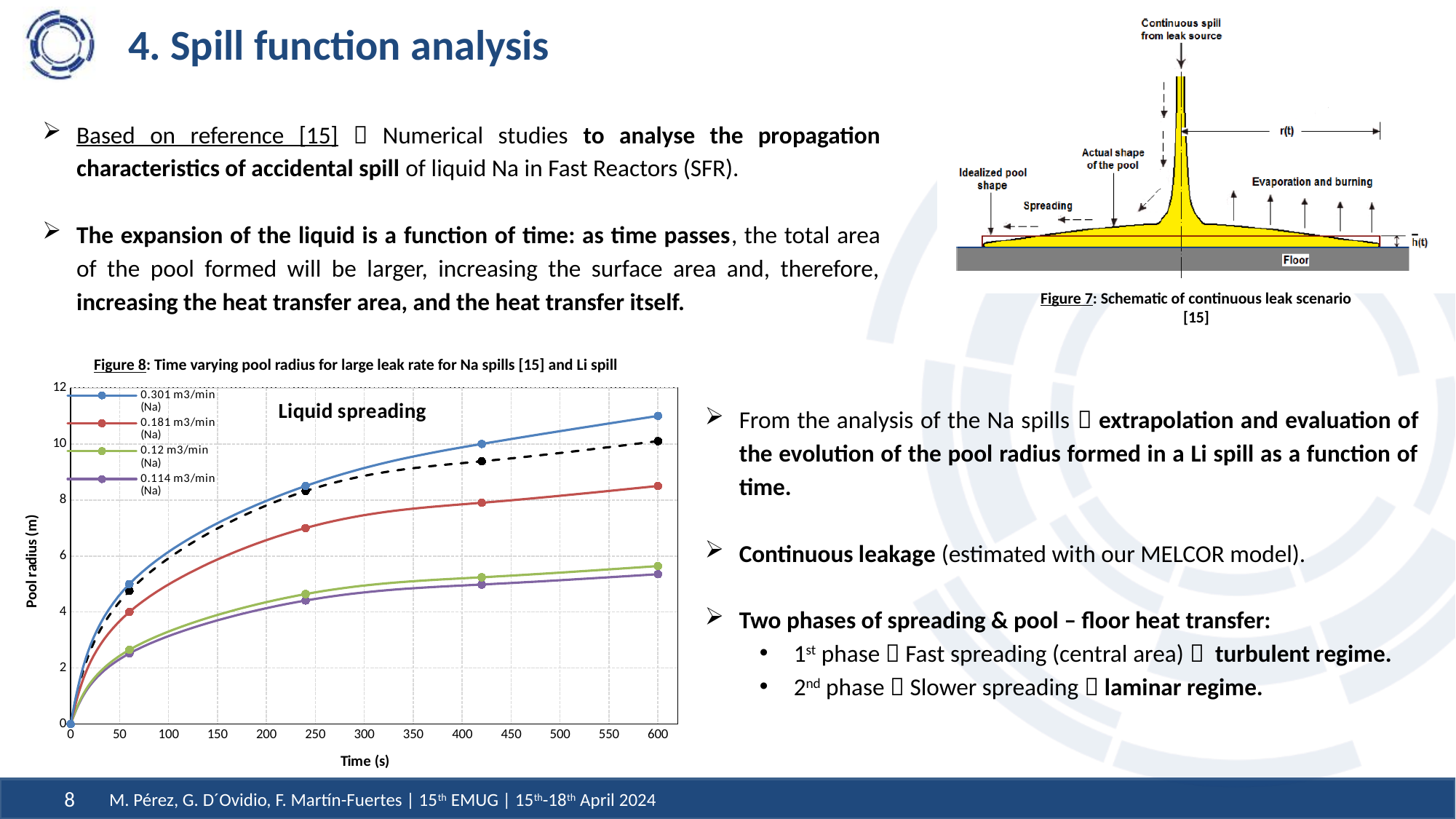
In the Liquid spreading chart, which legend series has the highest pool radius at 600 s? 0.301 m3/min (Na) In the Liquid spreading chart, which legend series has the lowest pool radius at 600 s? 0.114 m3/min (Na) In the Liquid spreading chart, which series has the larger pool radius at 420 s: 0.181 m3/min (Na) or 0.12 m3/min (Na)? 0.181 m3/min (Na) What is the label of the y axis in the Liquid spreading chart? Pool radius (m) What is the label of the x axis in the Liquid spreading chart? Time (s) What kind of chart is Figure 8 (Liquid spreading)? line chart In the Liquid spreading chart, is the pool radius for 0.12 m3/min (Na) at 600 s greater or less than 6? less In the Liquid spreading chart, is the pool radius for 0.301 m3/min (Na) at 240 s greater or less than 8? greater How many series does the legend of the Liquid spreading chart list? 4 In the Liquid spreading chart, does the pool radius rise or fall as time increases? rise In the Liquid spreading chart, is the pool radius for 0.301 m3/min (Na) at 600 s greater or less than 10? greater